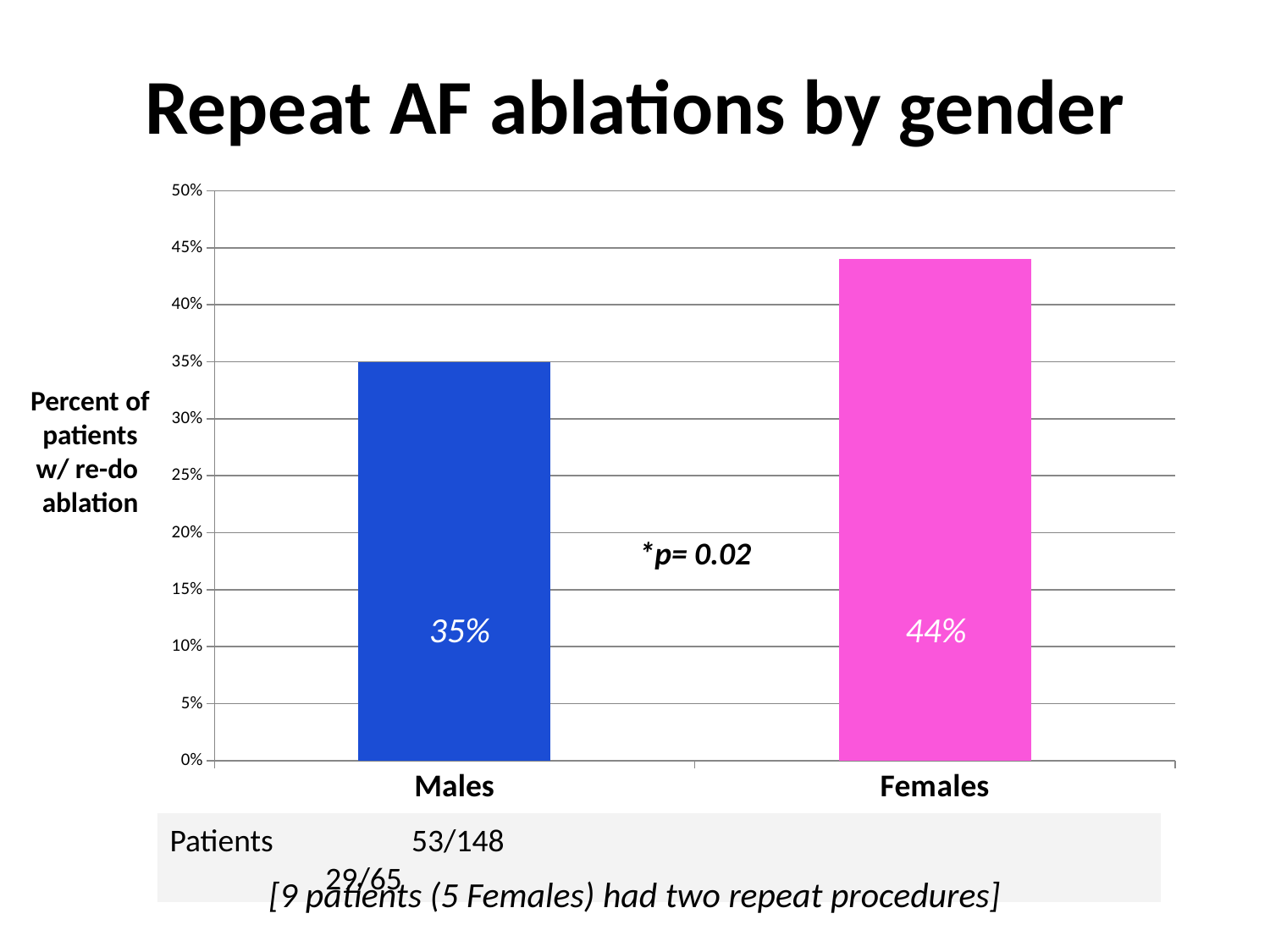
Is the value for Females greater or less than 40%? greater What is the value for Females? 44% Is the value for Males greater or less than 40%? less What is the title of the chart? Repeat AF ablations by gender What is the value for Males? 35% How many categories are shown on the x axis? 2 What colour is the bar for Females? pink Which category has the highest value? Females Which is larger, the value for Males or the value for Females? Females Which category has the lowest value? Males What kind of chart is shown on the slide? bar chart What is the difference between the values for Females and Males? 9%